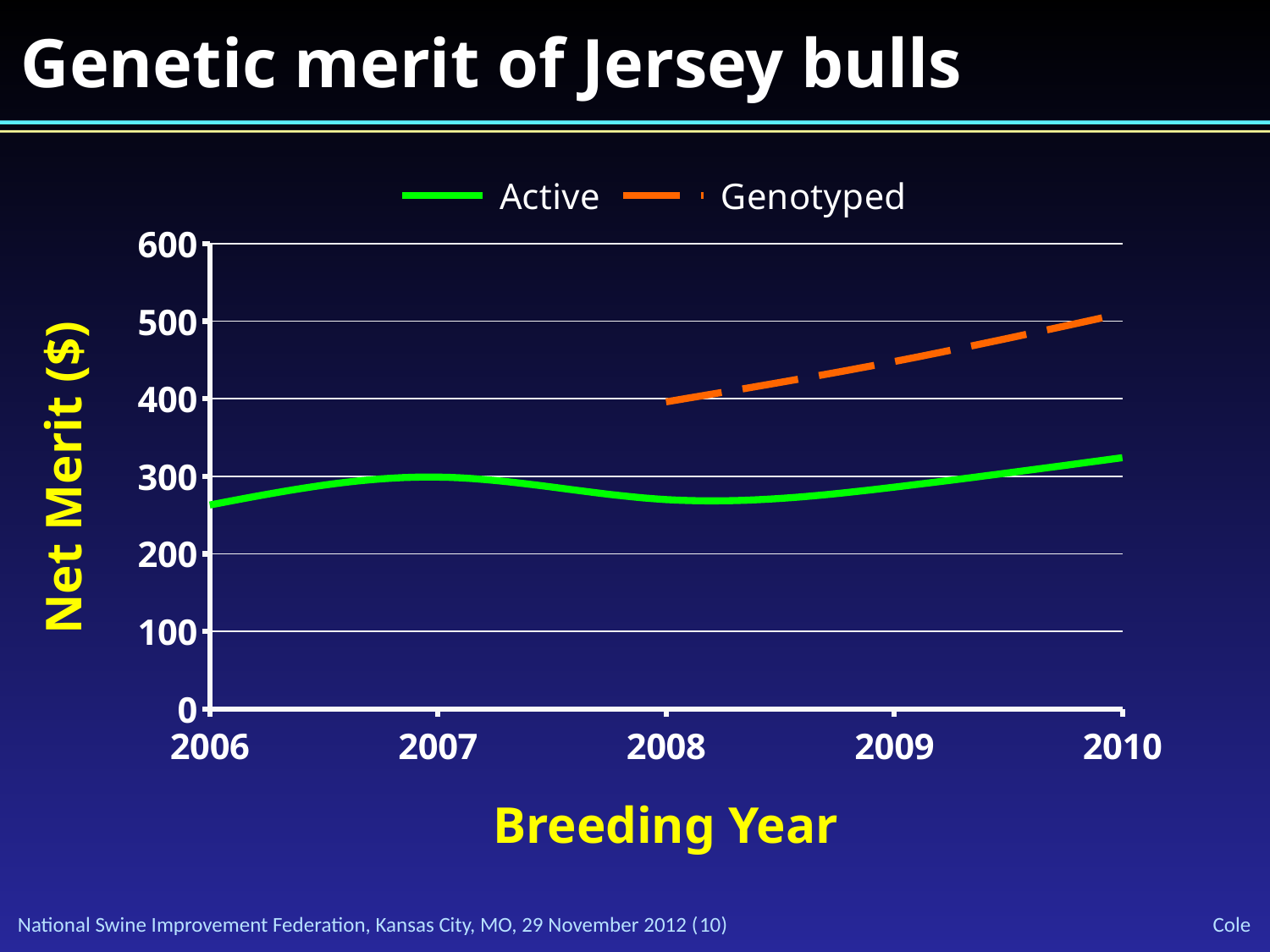
In 2010, which series has the higher Net Merit, Active or Genotyped? Genotyped What is the title of the chart? Genetic merit of Jersey bulls How many breeding years are labelled on the x axis? 5 Is the Active value for 2010 greater or less than 300? greater What is the label of the y axis? Net Merit ($) Does the Genotyped line rise or fall from 2008 to 2010? rise Is the Active value for 2006 greater or less than 300? less What kind of chart is shown on the slide? line chart Is the Genotyped value for 2008 greater or less than 500? less How many series does the legend list? 2